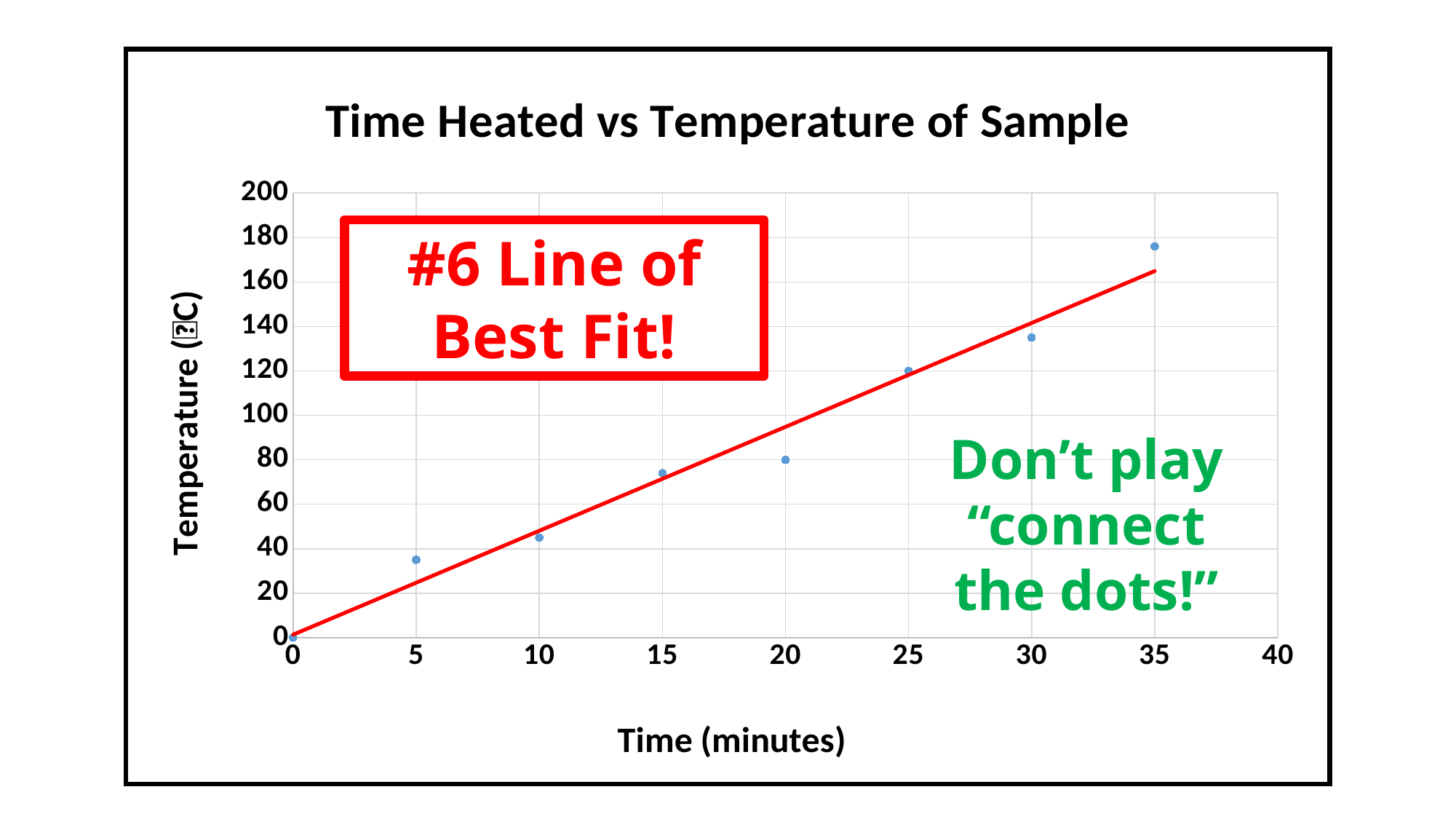
At which time (in minutes) is the temperature highest? 35 What is the title of the chart? Time Heated vs Temperature of Sample What is the temperature at 25 minutes? 120 At which time (in minutes) is the temperature lowest? 0 How many data points are plotted on the chart? 8 What is the temperature at 20 minutes? 80 Is the temperature at 35 minutes greater or less than 160? greater Which has the higher temperature, 15 minutes or 30 minutes? 30 minutes Is the temperature at 5 minutes greater or less than 40? less What is the label of the x axis? Time (minutes) What kind of chart is shown on the slide? scatter chart Do the temperature values rise or fall as time increases along the x axis? rise